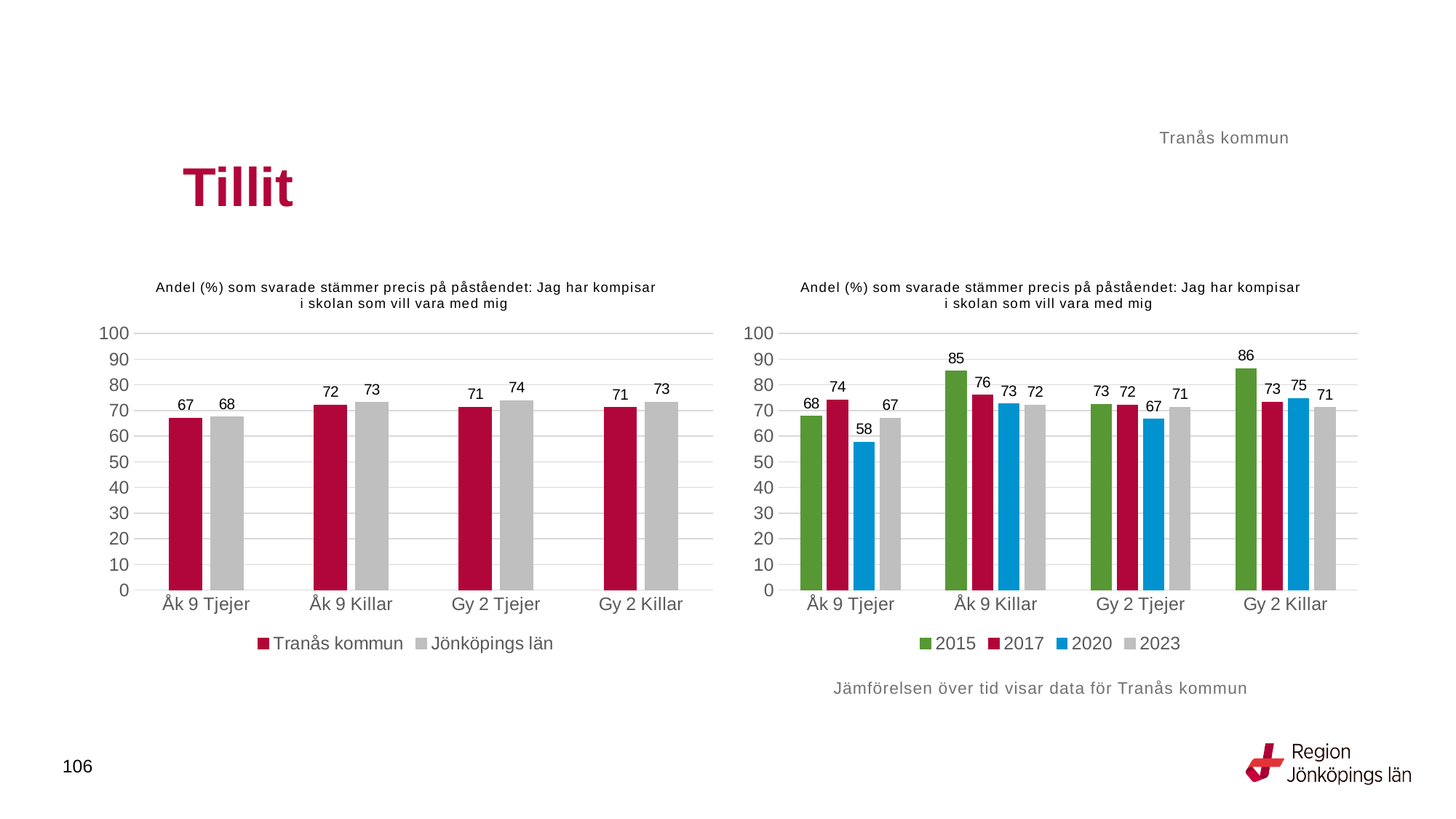
In the left chart, what is the value for Jönköpings län for Gy 2 Tjejer? 74 In the left chart, what is the difference between Jönköpings län and Tranås kommun for Gy 2 Tjejer? 3 In the right chart, what is the difference between the 2015 and 2023 values for Åk 9 Killar? 13 In the right chart, what is the value for 2020 for Åk 9 Tjejer? 58 In the left chart, what is the value for Tranås kommun for Åk 9 Tjejer? 67 In the right chart, which category has the lowest 2020 value? Åk 9 Tjejer In the right chart, which category has the highest 2015 value? Gy 2 Killar What kind of chart is the left chart? Bar chart In the right chart, which is larger for Gy 2 Tjejer: the 2015 value or the 2020 value? 2015 In the right chart, how many series does the legend list? 4 In the left chart, how many series does the legend list? 2 In the right chart, what is the value for 2015 for Gy 2 Killar? 86